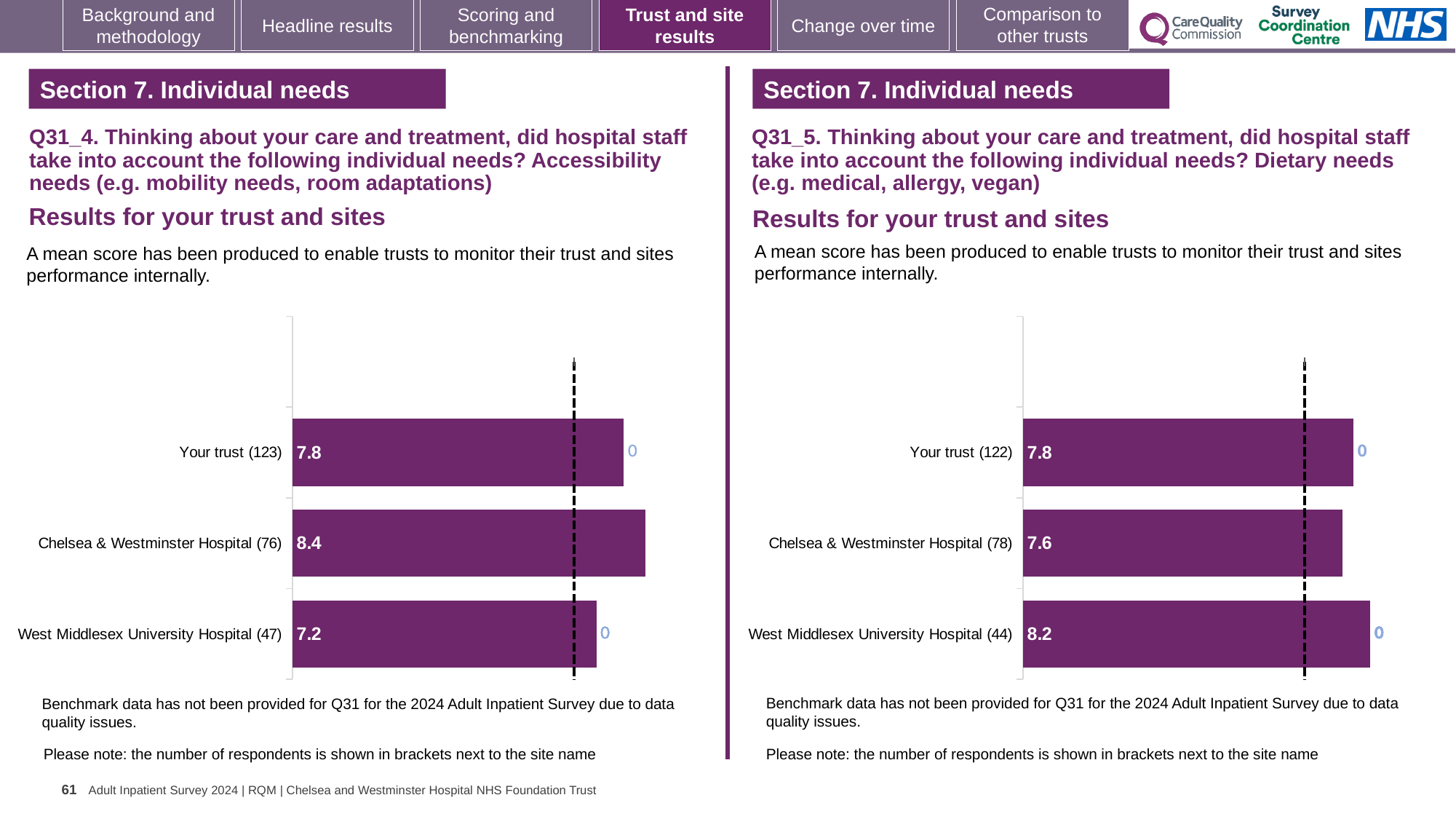
In the left chart (Q31_4, accessibility needs), which site or trust has the highest mean score? Chelsea & Westminster Hospital In the left chart (Q31_4, accessibility needs), what is the mean score for West Middlesex University Hospital? 7.2 What type of chart is used in the right chart (Q31_5, dietary needs)? Bar chart In the left chart (Q31_4, accessibility needs), how many respondents are shown in brackets for Your trust? 123 In the right chart (Q31_5, dietary needs), what is the mean score for Your trust? 7.8 How many bars are plotted in the left chart (Q31_4, accessibility needs)? 3 In the right chart (Q31_5, dietary needs), which site or trust has the lowest mean score? Chelsea & Westminster Hospital In the right chart (Q31_5, dietary needs), what is the mean score for West Middlesex University Hospital? 8.2 In the right chart (Q31_5, dietary needs), how many respondents are shown in brackets for West Middlesex University Hospital? 44 In the left chart (Q31_4, accessibility needs), what is the mean score for Chelsea & Westminster Hospital? 8.4 In the right chart (Q31_5, dietary needs), which has the larger mean score: Chelsea & Westminster Hospital or West Middlesex University Hospital? West Middlesex University Hospital In the left chart (Q31_4, accessibility needs), what is the difference between the mean scores for Chelsea & Westminster Hospital and West Middlesex University Hospital? 1.2